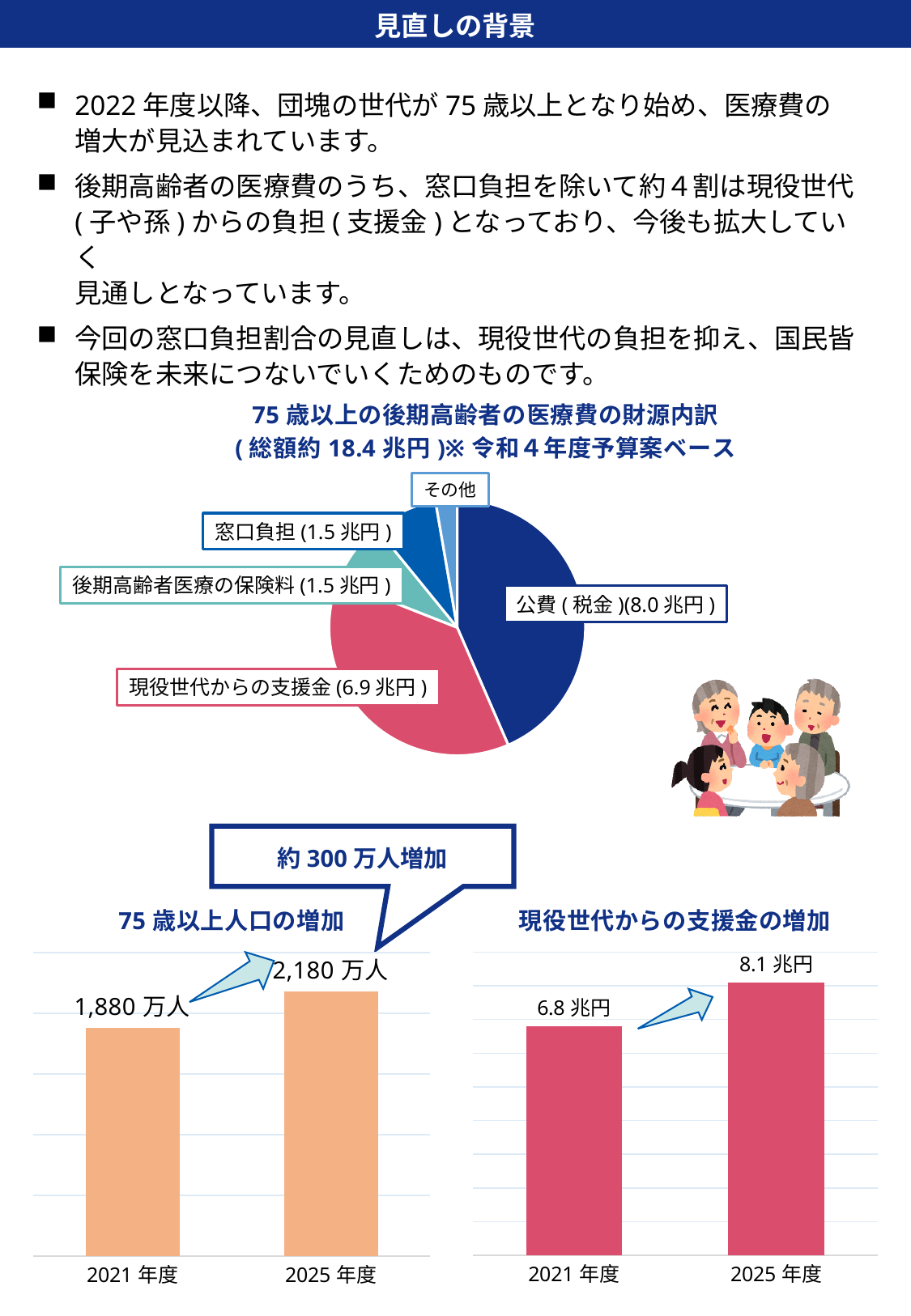
What type of chart is 「現役世代からの支援金の増加」? Bar chart In the chart 「現役世代からの支援金の増加」, do the values rise or fall from 2021年度 to 2025年度? Rise How many slices does the pie chart 「75歳以上の後期高齢者の医療費の財源内訳」 have? 5 In the pie chart 「75歳以上の後期高齢者の医療費の財源内訳」, what is the difference between 公費(税金) and 現役世代からの支援金? 1.1兆円 In the pie chart 「75歳以上の後期高齢者の医療費の財源内訳」, what is the value for 公費(税金)? 8.0兆円 In the chart 「現役世代からの支援金の増加」, what is the value for 2025年度? 8.1兆円 In the pie chart 「75歳以上の後期高齢者の医療費の財源内訳」, what is the value for 現役世代からの支援金? 6.9兆円 In the pie chart 「75歳以上の後期高齢者の医療費の財源内訳」, which slice is the smallest? その他 In the pie chart 「75歳以上の後期高齢者の医療費の財源内訳」, which slice is the largest? 公費(税金) What type of chart is 「75歳以上の後期高齢者の医療費の財源内訳」? Pie chart In the chart 「75歳以上人口の増加」, what is the value for 2021年度? 1,880万人 In the chart 「75歳以上人口の増加」, what is the difference between 2025年度 and 2021年度? 300万人